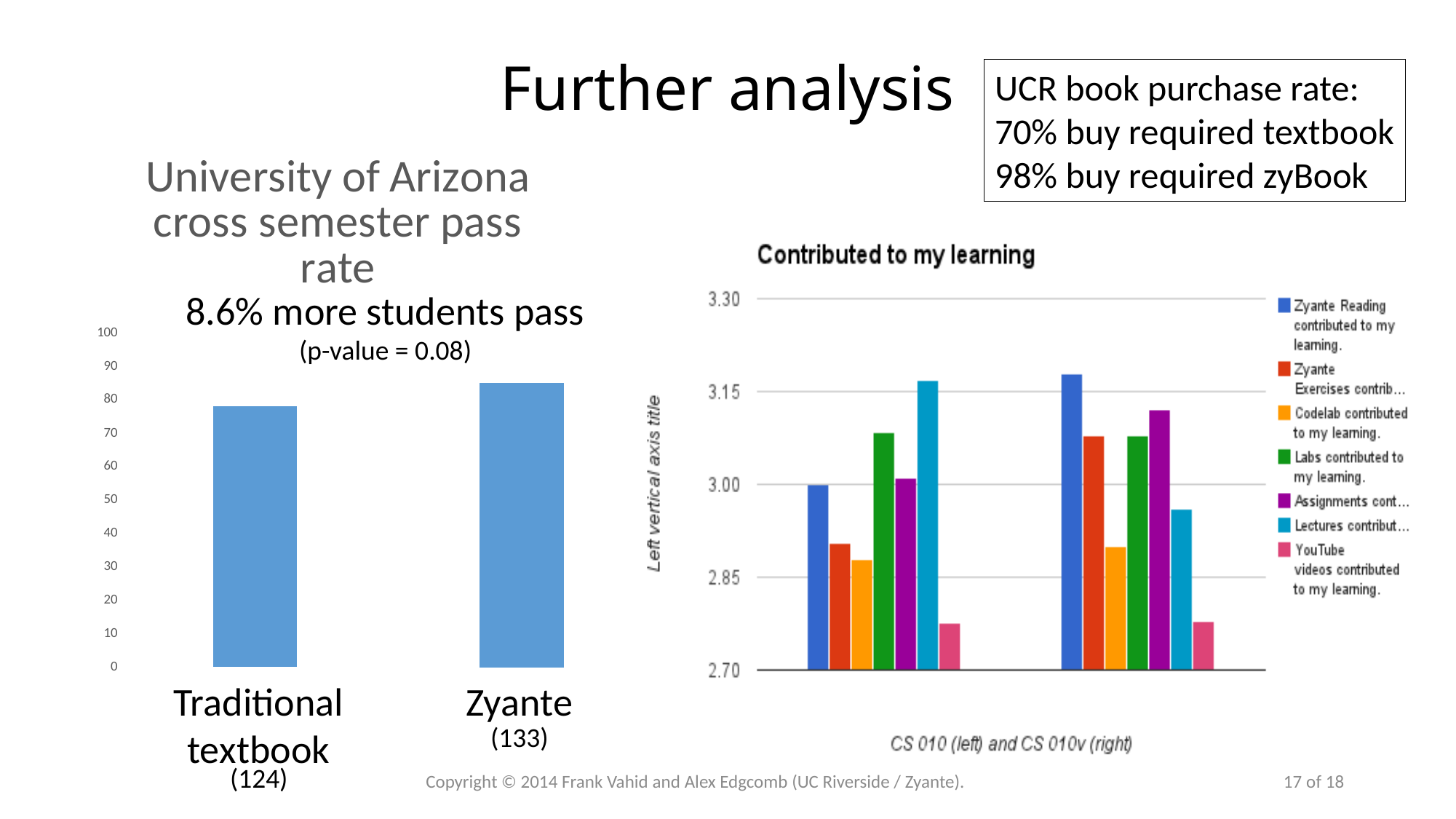
On the University of Arizona cross semester pass rate chart, how many categories are plotted? 2 On the 'Contributed to my learning' chart, is the value for YouTube videos in the CS 010v (right) group greater or less than 2.85? less On the 'Contributed to my learning' chart, which series has the lowest value in the CS 010 (left) group? YouTube videos contributed to my learning. On the 'Contributed to my learning' chart, which series has the highest value in the CS 010 (left) group? Lectures contribut... On the 'Contributed to my learning' chart, which series has the highest value in the CS 010v (right) group? Zyante Reading contributed to my learning. On the University of Arizona cross semester pass rate chart, is the value for Traditional textbook greater or less than 70? greater On the University of Arizona cross semester pass rate chart, which category has the higher bar, Traditional textbook or Zyante? Zyante What is the title of the chart on the right side of the slide? Contributed to my learning On the 'Contributed to my learning' chart, how many series does the legend list? 7 What kind of chart is the University of Arizona cross semester pass rate chart? bar chart On the University of Arizona cross semester pass rate chart, is the value for Zyante greater or less than 80? greater